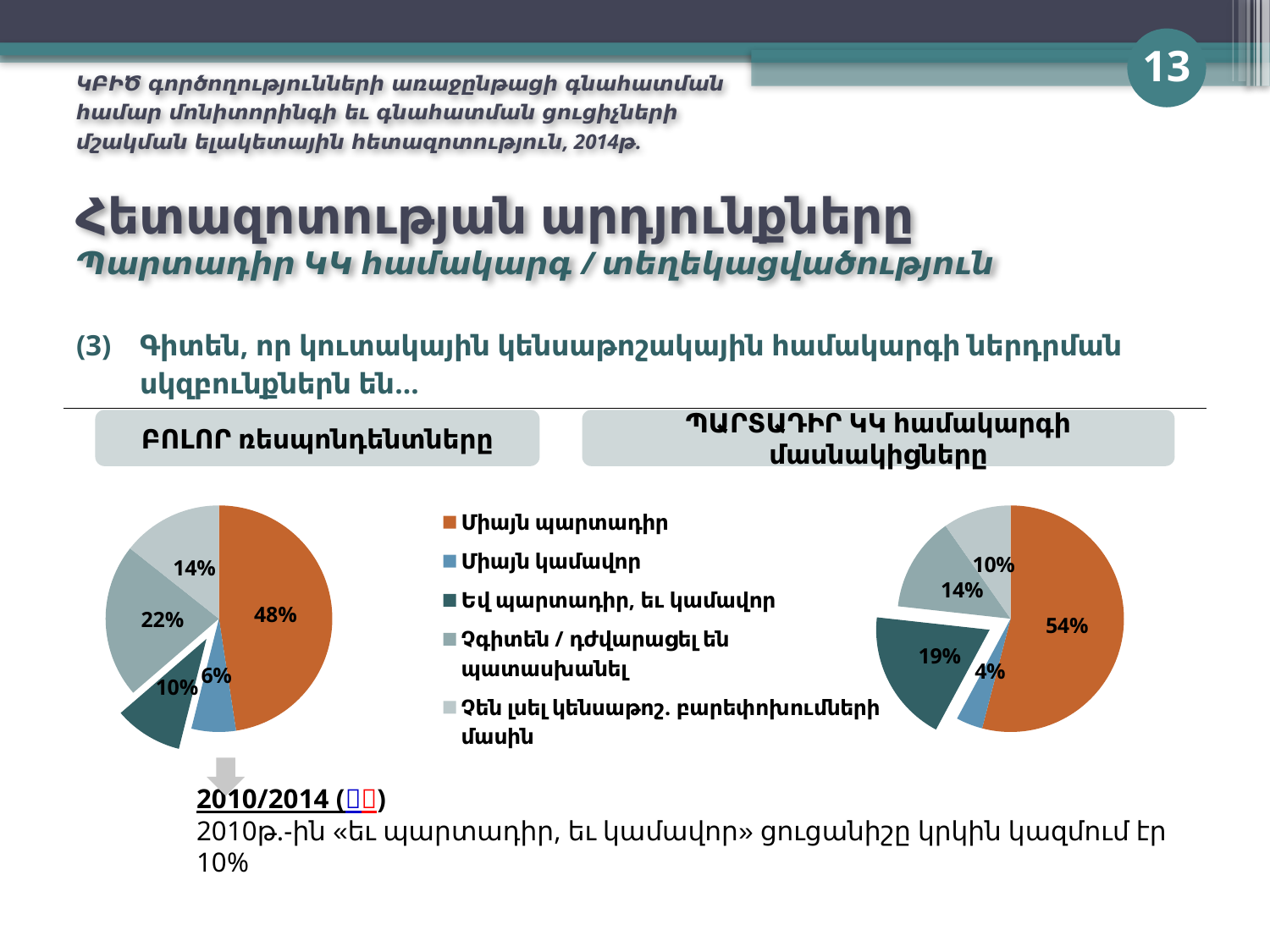
How many slices does each pie chart on the slide have? 5 In the right pie chart (ՊԱՐՏԱԴԻՐ ԿԿ համակարգի մասնակիցները), what share is labelled for the 'Միայն պարտադիր' slice? 54% In the left pie chart (ԲՈԼՈՐ ռեսպոնդենտները), which category has the largest slice? Միայն պարտադիր In the left pie chart (ԲՈԼՈՐ ռեսպոնդենտները), what share is labelled for the 'Միայն պարտադիր' slice? 48% What is the difference between the 'Միայն պարտադիր' share in the right pie chart and in the left pie chart? 6% What type of chart is used on the slide for both 'ԲՈԼՈՐ ռեսպոնդենտները' and 'ՊԱՐՏԱԴԻՐ ԿԿ համակարգի մասնակիցները'? Pie chart In the right pie chart (ՊԱՐՏԱԴԻՐ ԿԿ համակարգի մասնակիցները), which category has the smallest slice? Միայն կամավոր In the left pie chart (ԲՈԼՈՐ ռեսպոնդենտները), which category has the smallest slice? Միայն կամավոր How many entries does the shared legend between the two pie charts list? 5 In the right pie chart (ՊԱՐՏԱԴԻՐ ԿԿ համակարգի մասնակիցները), what share is labelled for 'Եվ պարտադիր, եւ կամավոր'? 19% Which is larger: the 'Չգիտեն / դժվարացել են պատասխանել' share in the left pie chart or in the right pie chart? Left pie chart (22%) In the left pie chart (ԲՈԼՈՐ ռեսպոնդենտները), what share is labelled for 'Եվ պարտադիր, եւ կամավոր'? 10%